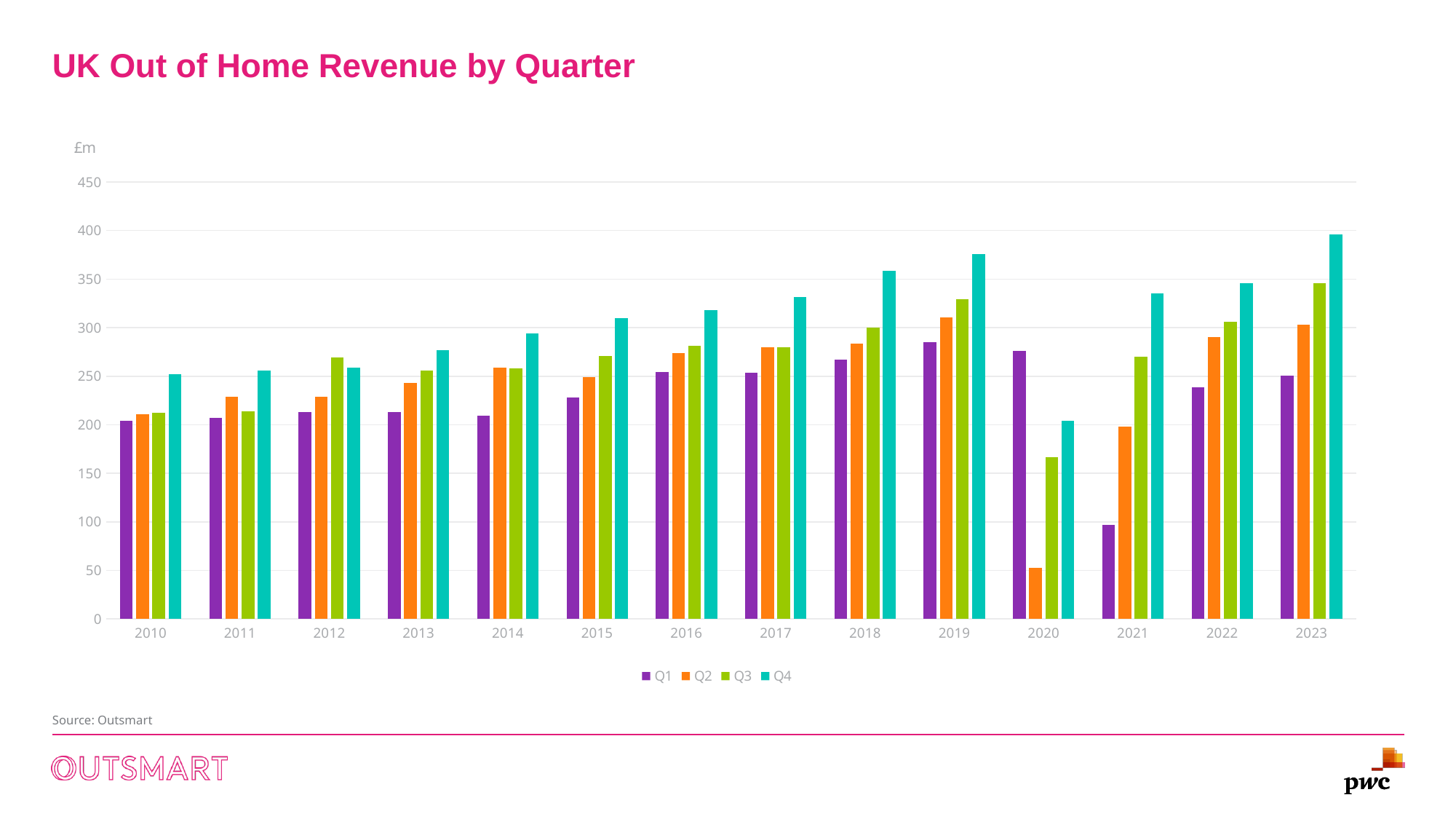
Is the value for Q3 in 2020 greater or less than 150? greater How many years are shown on the x axis? 14 What unit is shown on the y axis? £m Which year and quarter has the highest revenue bar? 2023 Q4 Which is larger in 2012, the Q3 bar or the Q4 bar? Q3 Which year and quarter has the lowest revenue bar? 2020 Q2 What kind of chart is shown on the slide? Bar chart Is the value for Q4 in 2019 greater or less than 350? greater Is the value for Q1 in 2020 greater or less than 250? greater Does the Q4 revenue rise or fall from 2010 to 2019? Rise How many series does the legend list? 4